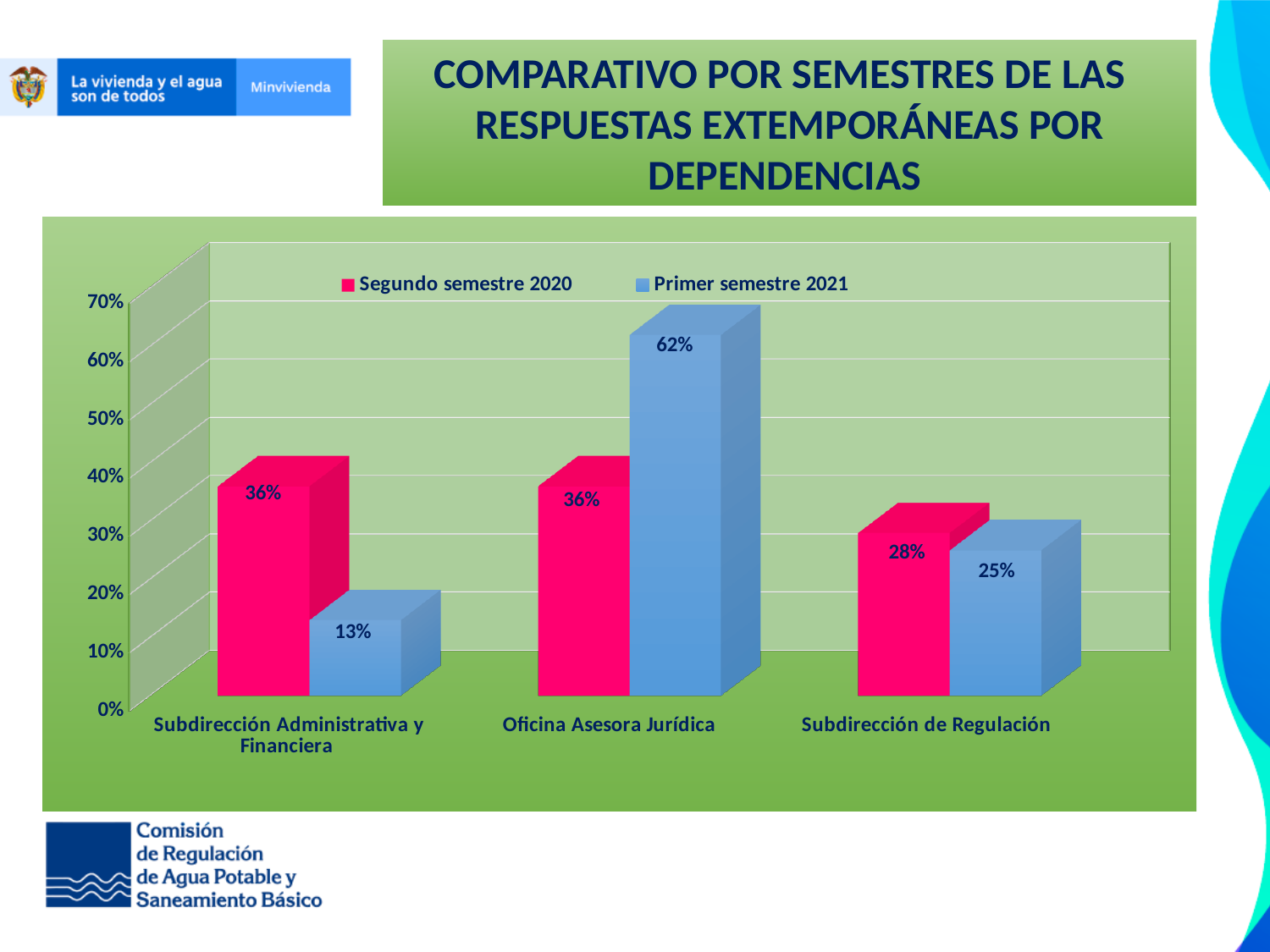
What is the value for Subdirección Administrativa y Financiera in the Primer semestre 2021 series? 13% Which colour represents the Primer semestre 2021 series? Blue For Subdirección de Regulación, which series has the larger value, Segundo semestre 2020 or Primer semestre 2021? Segundo semestre 2020 What is the value for Oficina Asesora Jurídica in the Primer semestre 2021 series? 62% Which category has the highest value in the Primer semestre 2021 series? Oficina Asesora Jurídica How many categories are shown on the x axis? 3 What kind of chart is shown on the slide? Bar chart How many series does the legend list? 2 What is the value for Subdirección de Regulación in the Primer semestre 2021 series? 25% What is the difference between the Primer semestre 2021 and Segundo semestre 2020 values for Oficina Asesora Jurídica? 26% What is the value for Subdirección Administrativa y Financiera in the Segundo semestre 2020 series? 36% Which category has the lowest value in the Segundo semestre 2020 series? Subdirección de Regulación